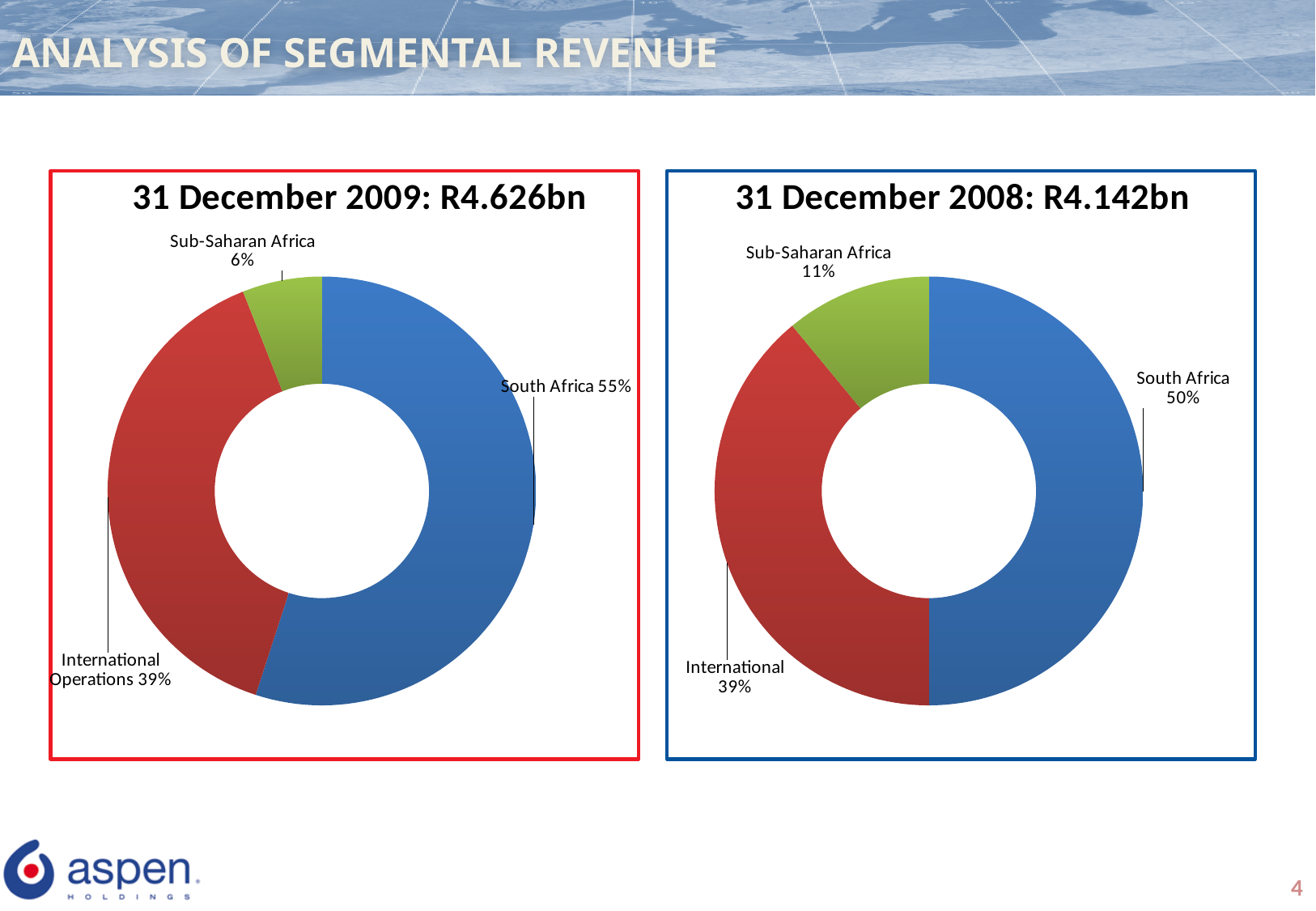
In the '31 December 2008: R4.142bn' chart, what share of revenue does Sub-Saharan Africa represent? 11% In the '31 December 2008: R4.142bn' chart, what share of revenue does South Africa represent? 50% In the '31 December 2009: R4.626bn' chart, what share of revenue does South Africa represent? 55% What is the total revenue shown in the title of the left chart? R4.626bn In the '31 December 2009: R4.626bn' chart, which segment has the largest share? South Africa How many segments are shown in the '31 December 2009: R4.626bn' chart? 3 Which is larger in the '31 December 2008: R4.142bn' chart: South Africa or International? South Africa In the '31 December 2009: R4.626bn' chart, what is the difference in percentage points between South Africa and International Operations? 16 What kind of chart is the '31 December 2008: R4.142bn' chart? Doughnut chart In the '31 December 2008: R4.142bn' chart, which segment has the smallest share? Sub-Saharan Africa In the '31 December 2009: R4.626bn' chart, what share of revenue does International Operations represent? 39% What colour is the Sub-Saharan Africa segment in the '31 December 2009: R4.626bn' chart? Green